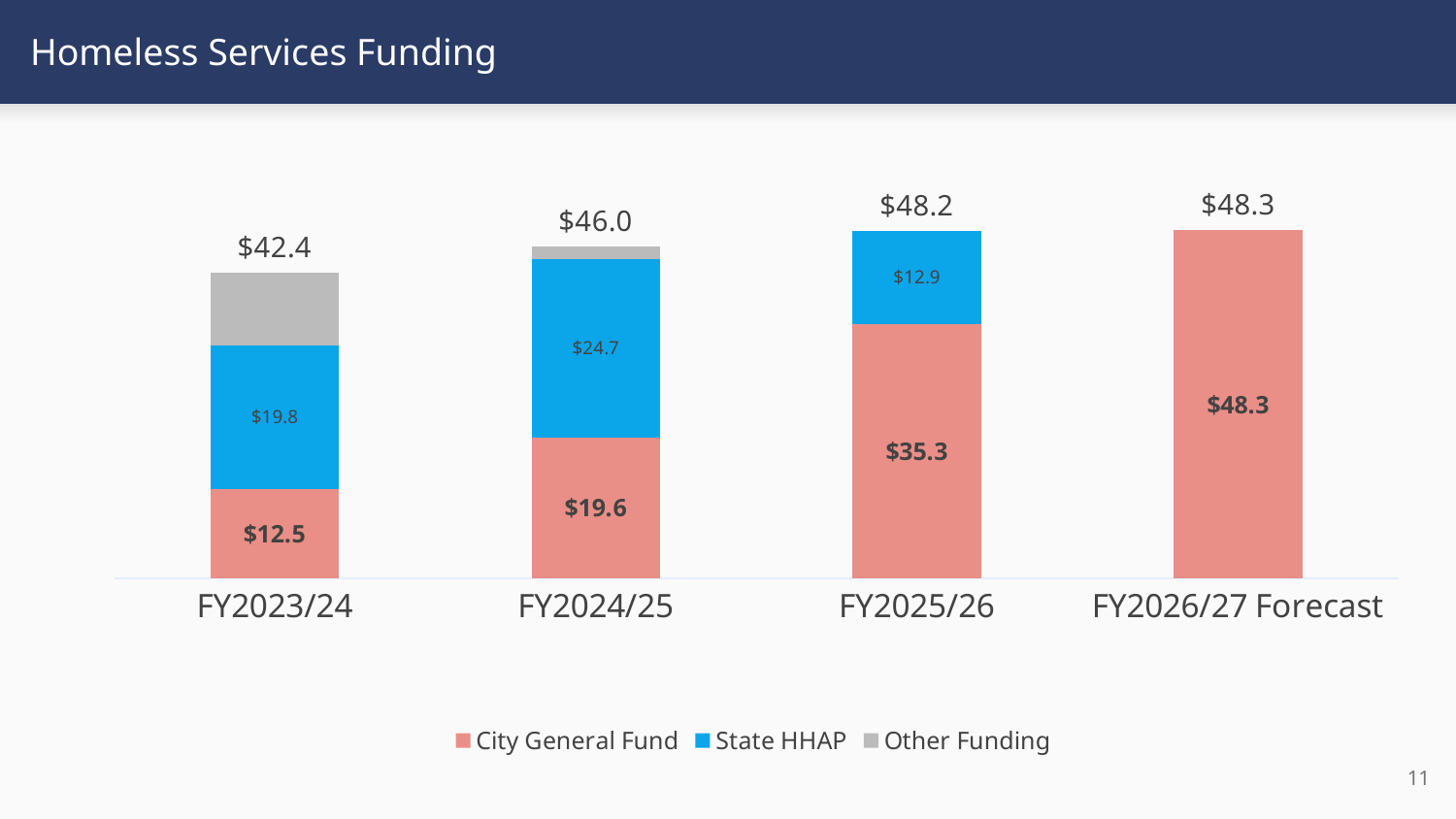
In which fiscal year is the City General Fund value lowest? FY2023/24 How many series does the legend list? 3 What is the City General Fund value for FY2025/26? $35.3 How much larger is the City General Fund value in FY2025/26 than in FY2024/25? $15.7 What is the State HHAP value for FY2024/25? $24.7 In FY2023/24, which is larger: City General Fund or State HHAP? State HHAP How many fiscal years are shown on the x axis? 4 What is the total funding shown for FY2026/27 Forecast? $48.3 In which fiscal year is the State HHAP value highest? FY2024/25 What is the difference between the total funding in FY2024/25 and FY2023/24? $3.6 What is the total funding shown for FY2023/24? $42.4 What type of chart is shown on the slide? Stacked bar chart